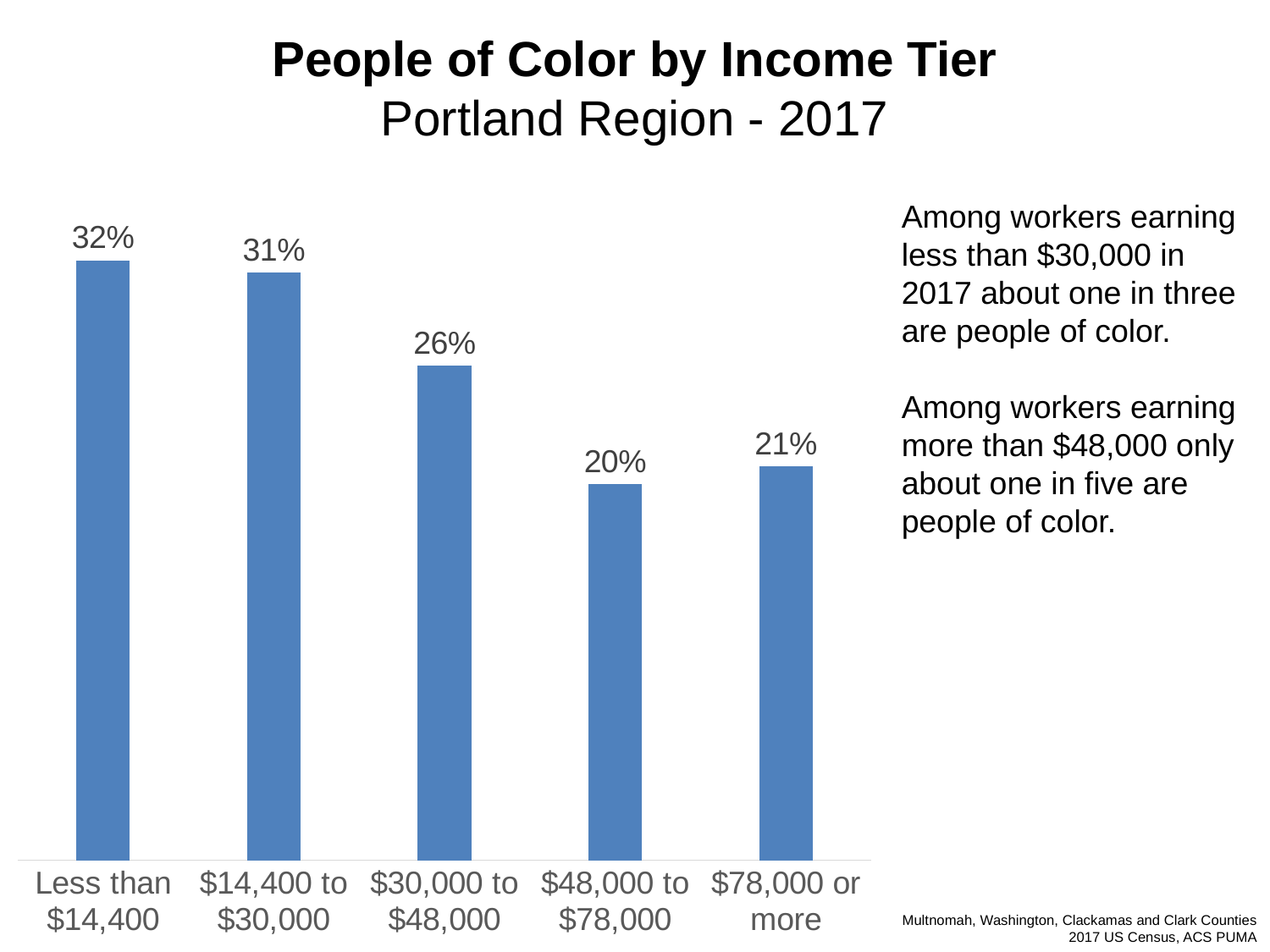
How many income tiers are shown in the chart? 5 Which income tier has the lowest share of people of color? $48,000 to $78,000 What is the value for the 'Less than $14,400' income tier? 32% Which is larger, the value for '$30,000 to $48,000' or the value for '$78,000 or more'? $30,000 to $48,000 Do the values generally rise or fall as income tier increases from left to right? Fall What kind of chart is shown on the slide? Bar chart What is the title of the chart? People of Color by Income Tier, Portland Region - 2017 What is the value for the '$30,000 to $48,000' income tier? 26% Which income tier has the highest share of people of color? Less than $14,400 What is the difference between the values for '$14,400 to $30,000' and '$30,000 to $48,000'? 5% What is the value for the '$78,000 or more' income tier? 21% What is the difference between the values for 'Less than $14,400' and '$48,000 to $78,000'? 12%